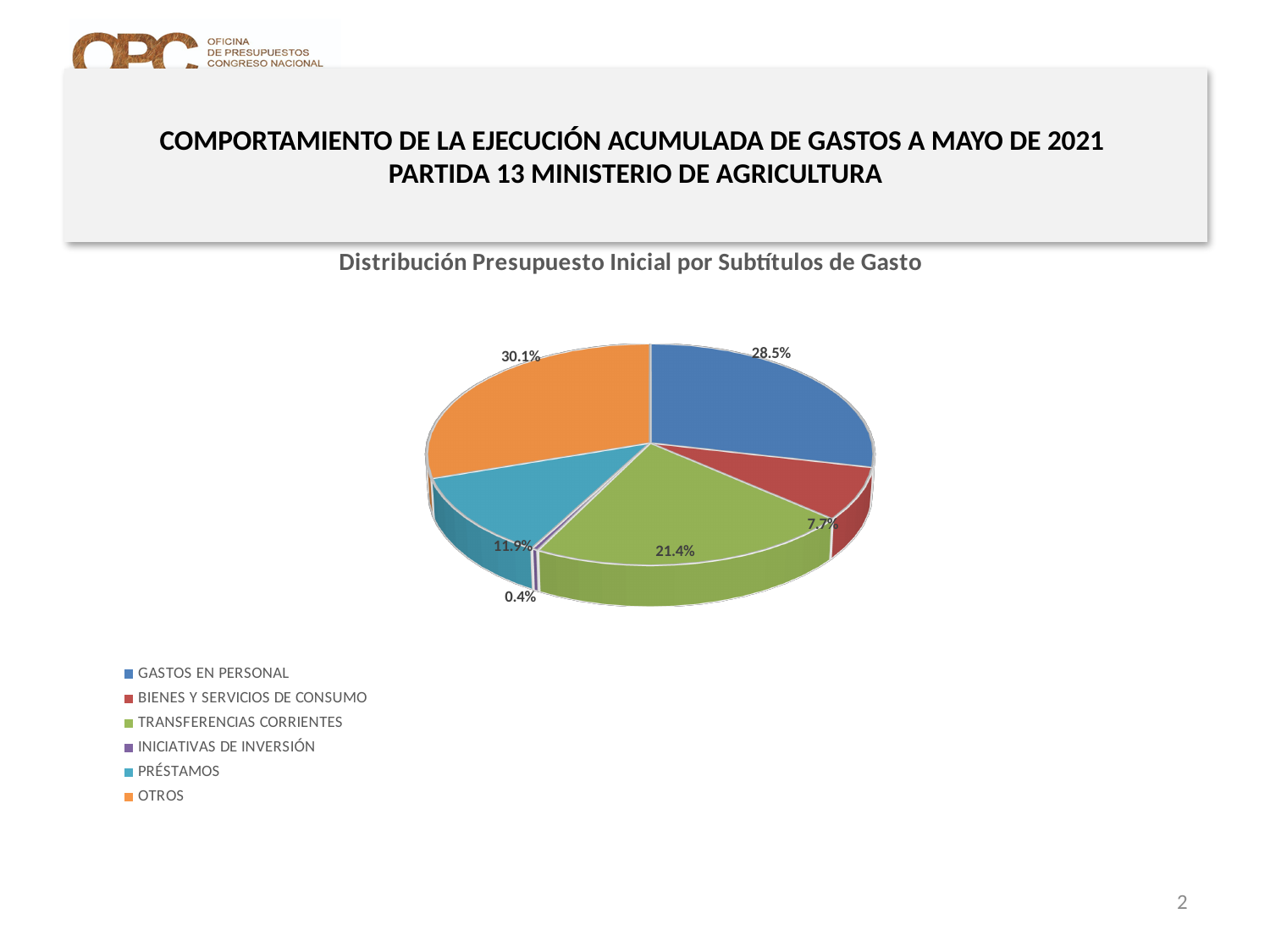
What share of the pie is GASTOS EN PERSONAL? 28.5% What share of the pie is OTROS? 30.1% What share of the pie is PRÉSTAMOS? 11.9% What is the title of the chart? Distribución Presupuesto Inicial por Subtítulos de Gasto How many categories does the legend list? 6 Which is larger, the share of TRANSFERENCIAS CORRIENTES or the share of PRÉSTAMOS? TRANSFERENCIAS CORRIENTES What is the difference between the shares of GASTOS EN PERSONAL and BIENES Y SERVICIOS DE CONSUMO? 20.8% Which category has the smallest share of the pie? INICIATIVAS DE INVERSIÓN Which category has the largest share of the pie? OTROS What type of chart is shown on the slide? Pie chart